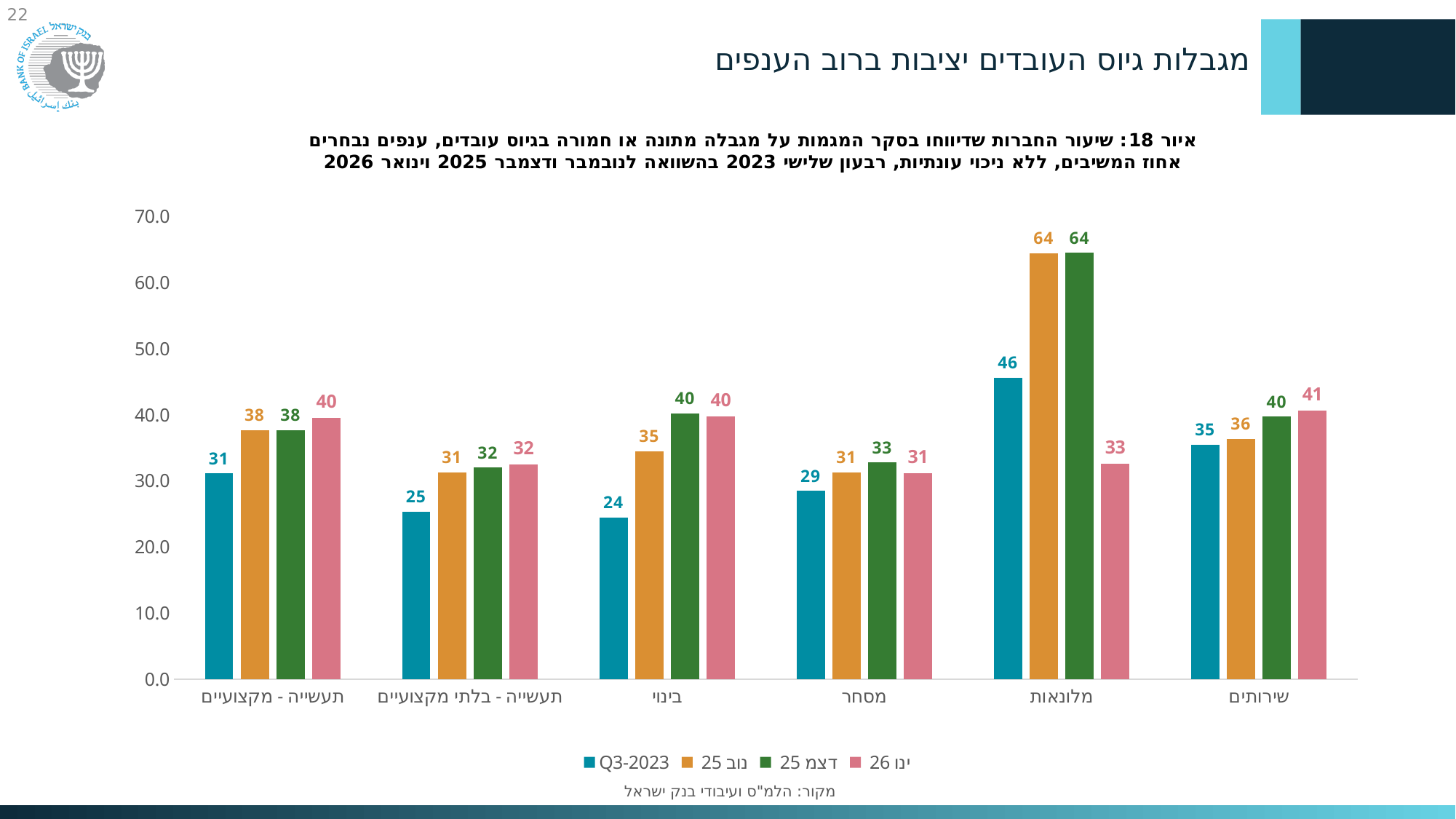
What is the difference between the דצמ 25 and ינו 26 values for מלונאות? 31 What is the value for מלונאות in the Q3-2023 series? 46 How many series does the legend list? 4 What is the value for בינוי in the נוב 25 series? 35 Which category has the highest value in the דצמ 25 series? מלונאות How many categories are shown on the x axis? 6 Is the value for מסחר in the ינו 26 series greater or less than 40? less What kind of chart is shown on the slide? bar chart Which is larger for תעשייה - בלתי מקצועיים: the Q3-2023 value or the נוב 25 value? נוב 25 What is the value for שירותים in the ינו 26 series? 41 What is the source cited below the chart? הלמ"ס ועיבודי בנק ישראל Which category has the lowest value in the Q3-2023 series? בינוי